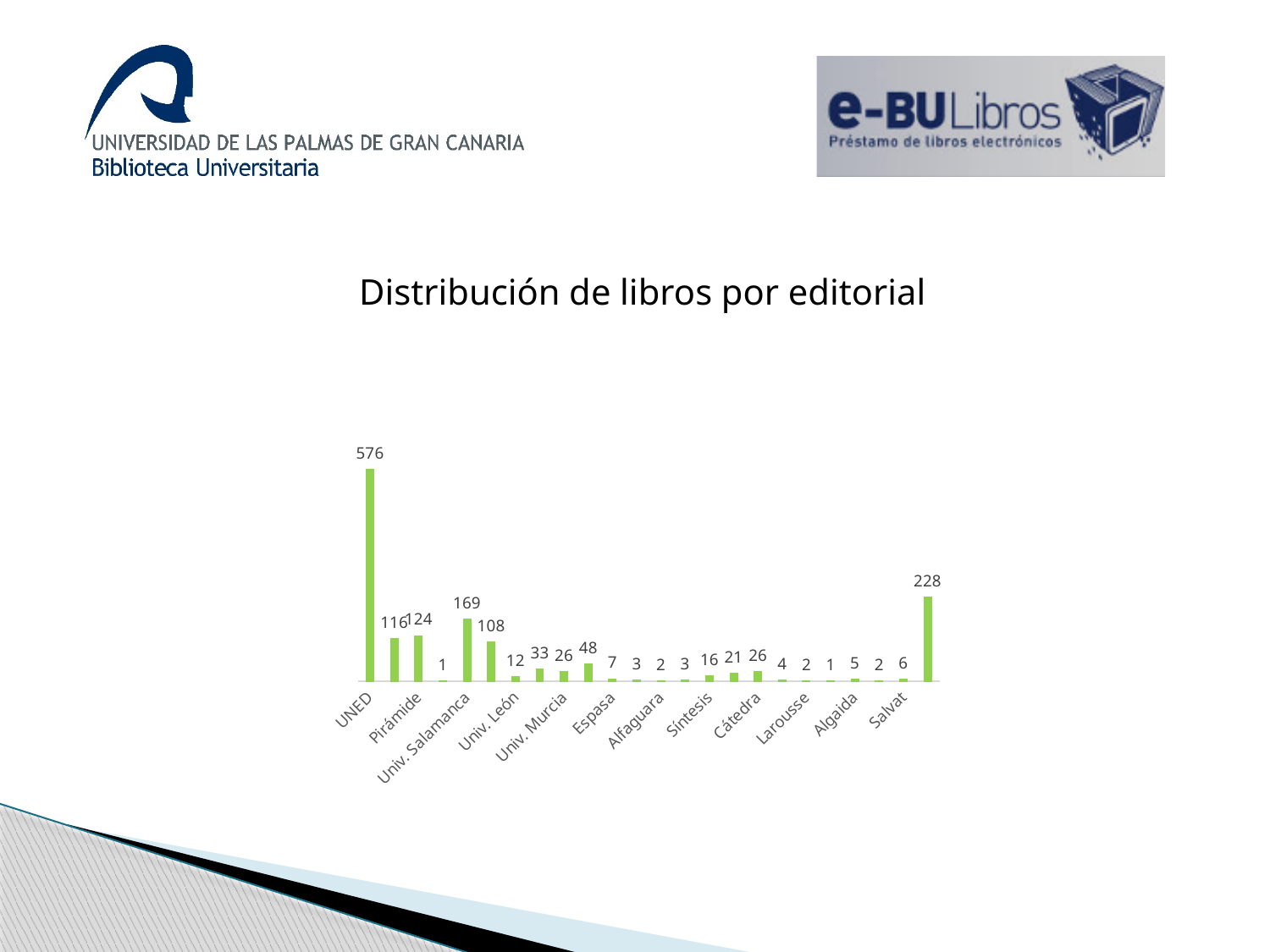
How many bars are plotted in the chart? 24 What is the value for Pirámide? 124 What is the difference between the values for UNED and Univ. Salamanca? 407 What is the value for Cátedra? 26 What is the value for UNED? 576 What is the title of the chart? Distribución de libros por editorial What is the value for Univ. Salamanca? 169 Which editorial has the highest number of books? UNED What is the value shown on the last bar at the right of the chart? 228 What colour are the bars in the chart? green What kind of chart is shown on the slide? bar chart Which is larger, the value for Univ. Salamanca or the value for Pirámide? Univ. Salamanca